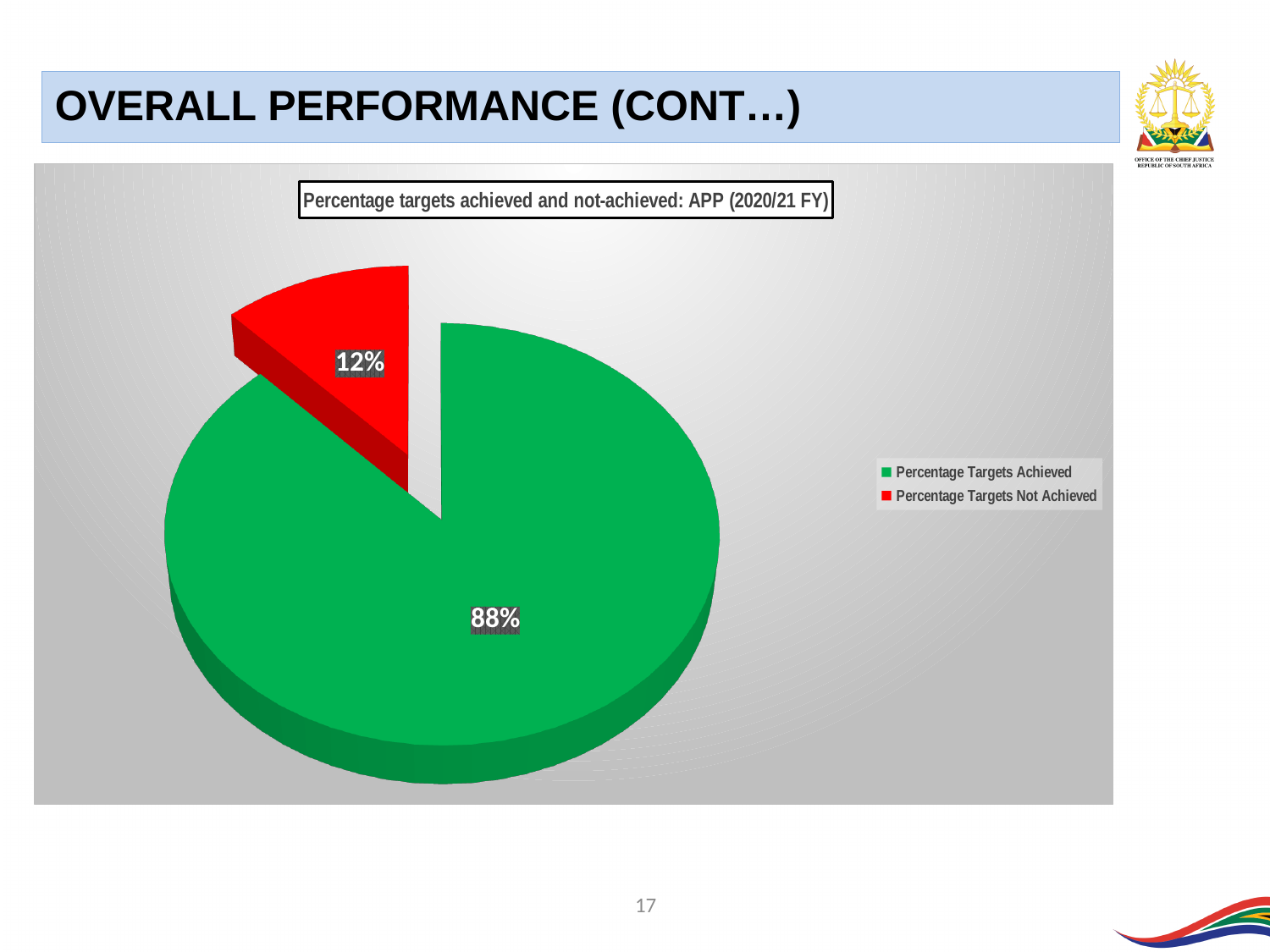
Which category has the smallest share of the pie chart? Percentage Targets Not Achieved What colour is the slice for Percentage Targets Achieved? Green Which is larger: the share of targets achieved or the share of targets not achieved? Percentage Targets Achieved What share of the pie does the red slice represent? 12% Which category has the largest share of the pie chart? Percentage Targets Achieved How many slices does the pie chart have? 2 What is the title of the chart? Percentage targets achieved and not-achieved: APP (2020/21 FY) What is the difference in percentage points between targets achieved and targets not achieved? 76 What kind of chart is shown on the slide? Pie chart What percentage of targets were achieved according to the pie chart? 88% What percentage of targets were not achieved according to the pie chart? 12% How many entries does the legend list? 2